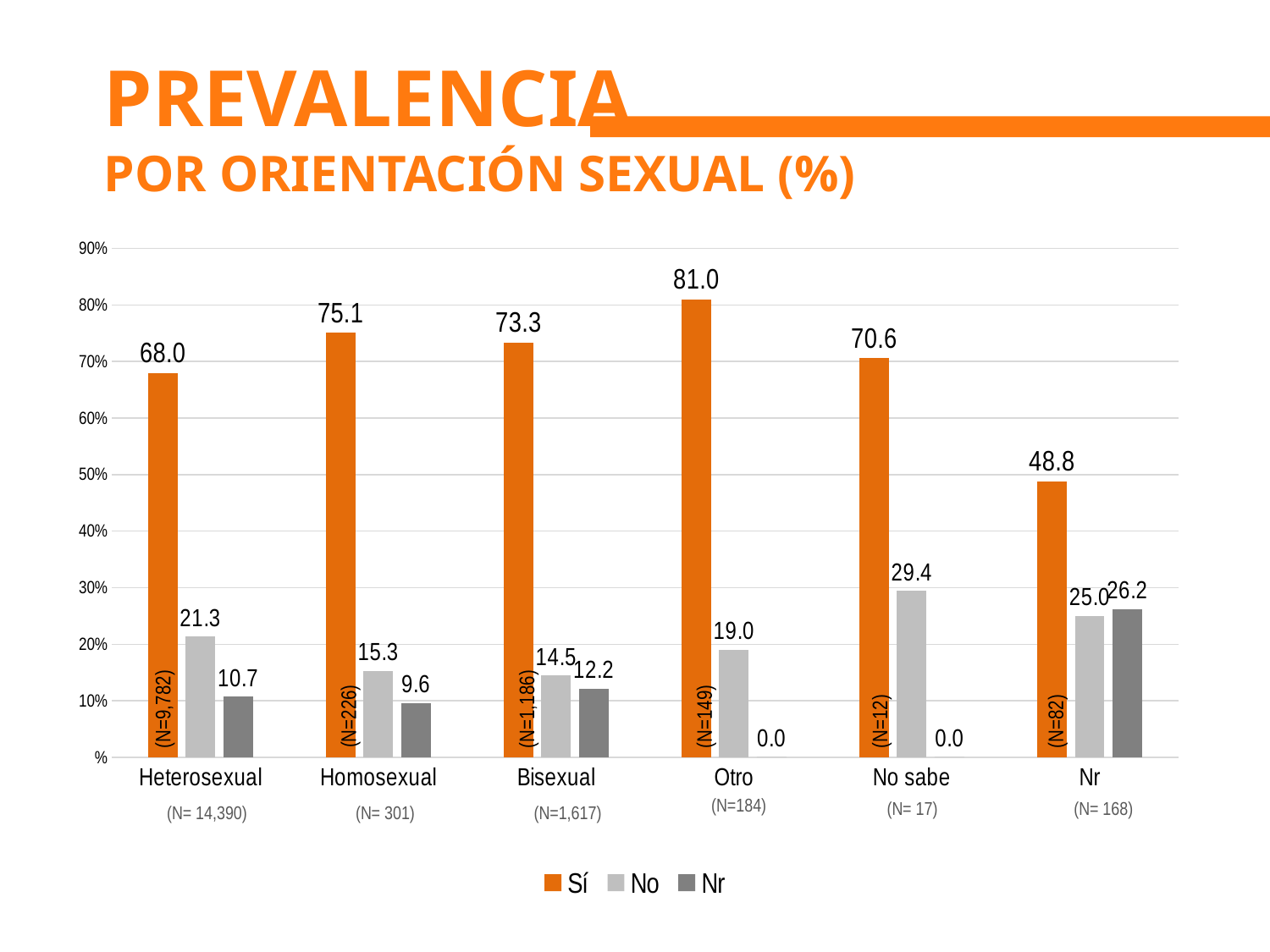
What is the difference between the Sí values for Homosexual and Bisexual? 1.8 Which category has the highest value in the Sí series? Otro How many series does the legend list? 3 What is the value of the No series for No sabe? 29.4 What is the value of the Sí series for Heterosexual? 68.0 Is the Sí value for No sabe greater or less than 60%? greater What kind of chart is shown on the slide? bar chart What is the value of the Nr series for Bisexual? 12.2 Which category has the lowest value in the Sí series? Nr What is the Nr value for Otro? 0.0 How many categories are shown on the x axis? 6 Which is larger: the No value for Heterosexual or the No value for Otro? Heterosexual